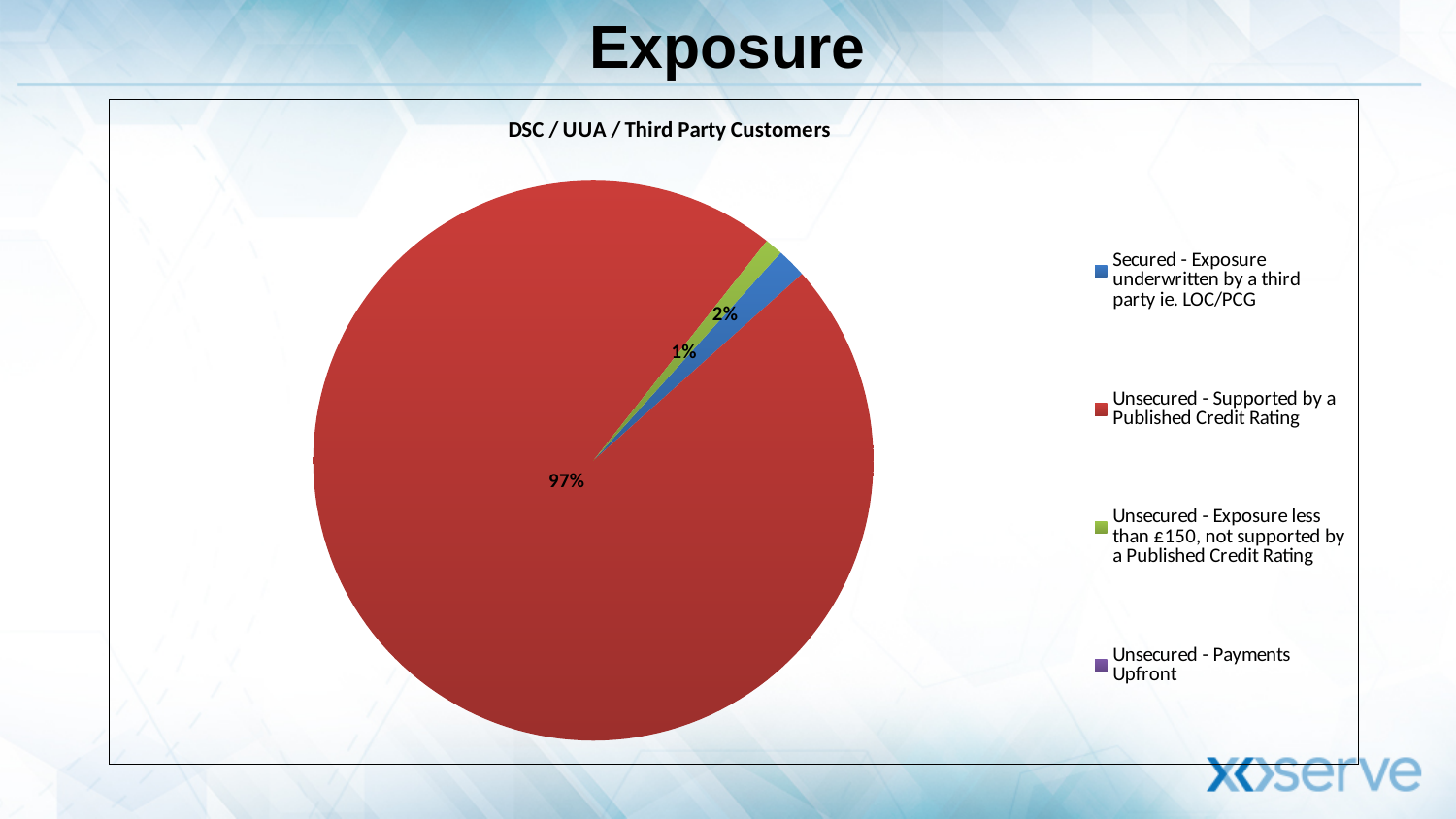
What share of the pie is 'Secured - Exposure underwritten by a third party ie. LOC/PCG'? 2% What is the difference in percentage points between the 'Unsecured - Supported by a Published Credit Rating' slice and the 'Secured - Exposure underwritten by a third party' slice? 95% What share of the pie is 'Unsecured - Exposure less than £150, not supported by a Published Credit Rating'? 1% Which category has the largest slice of the pie? Unsecured - Supported by a Published Credit Rating How many entries does the legend list? 4 What share of the pie is 'Unsecured - Supported by a Published Credit Rating'? 97% How many slices have a percentage label printed on the pie? 3 What kind of chart is shown on the slide? pie chart What is the title of the chart? DSC / UUA / Third Party Customers Which is larger: the 'Secured - Exposure underwritten by a third party' slice or the 'Unsecured - Exposure less than £150' slice? Secured - Exposure underwritten by a third party What colour represents 'Unsecured - Supported by a Published Credit Rating' in the chart? red